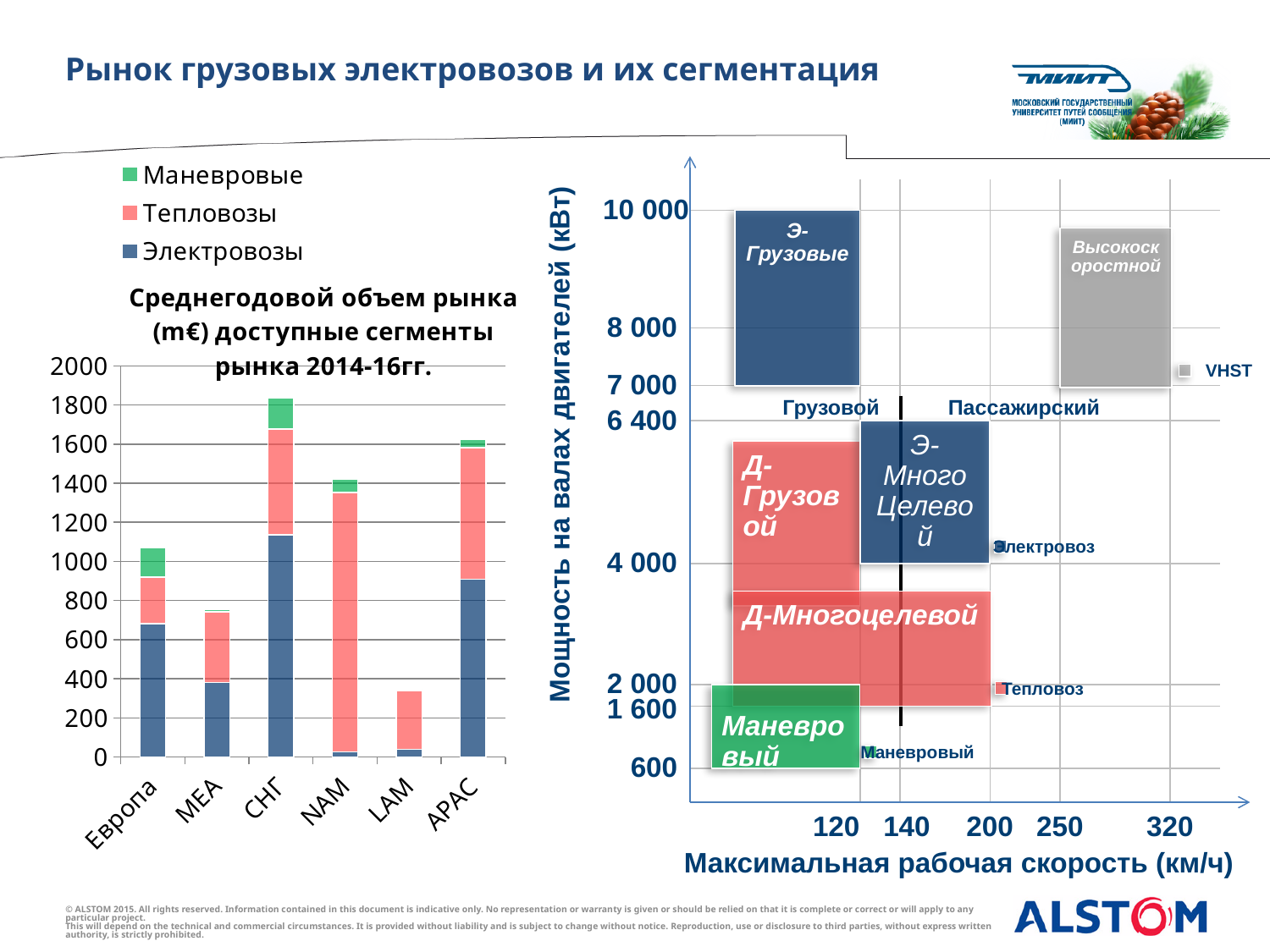
What kind of chart is the chart on the left of the slide? bar chart What period does the title of the bar chart refer to? 2014-16гг. Which category has the shortest stacked bar in the bar chart? LAM Which series is shown in green in the bar chart legend? Маневровые How many series does the legend of the bar chart list? 3 How many categories are shown on the x axis of the bar chart? 6 Is the total stacked value for NAM in the bar chart greater or less than 1200? greater Which category has the tallest stacked bar in the bar chart? СНГ In the bar chart, which stacked bar is taller, СНГ or APAC? СНГ In the bar chart, which stacked bar is taller, MEA or NAM? NAM Is the Электровозы segment for СНГ in the bar chart greater or less than 1000? greater Is the total stacked value for LAM in the bar chart greater or less than 400? less